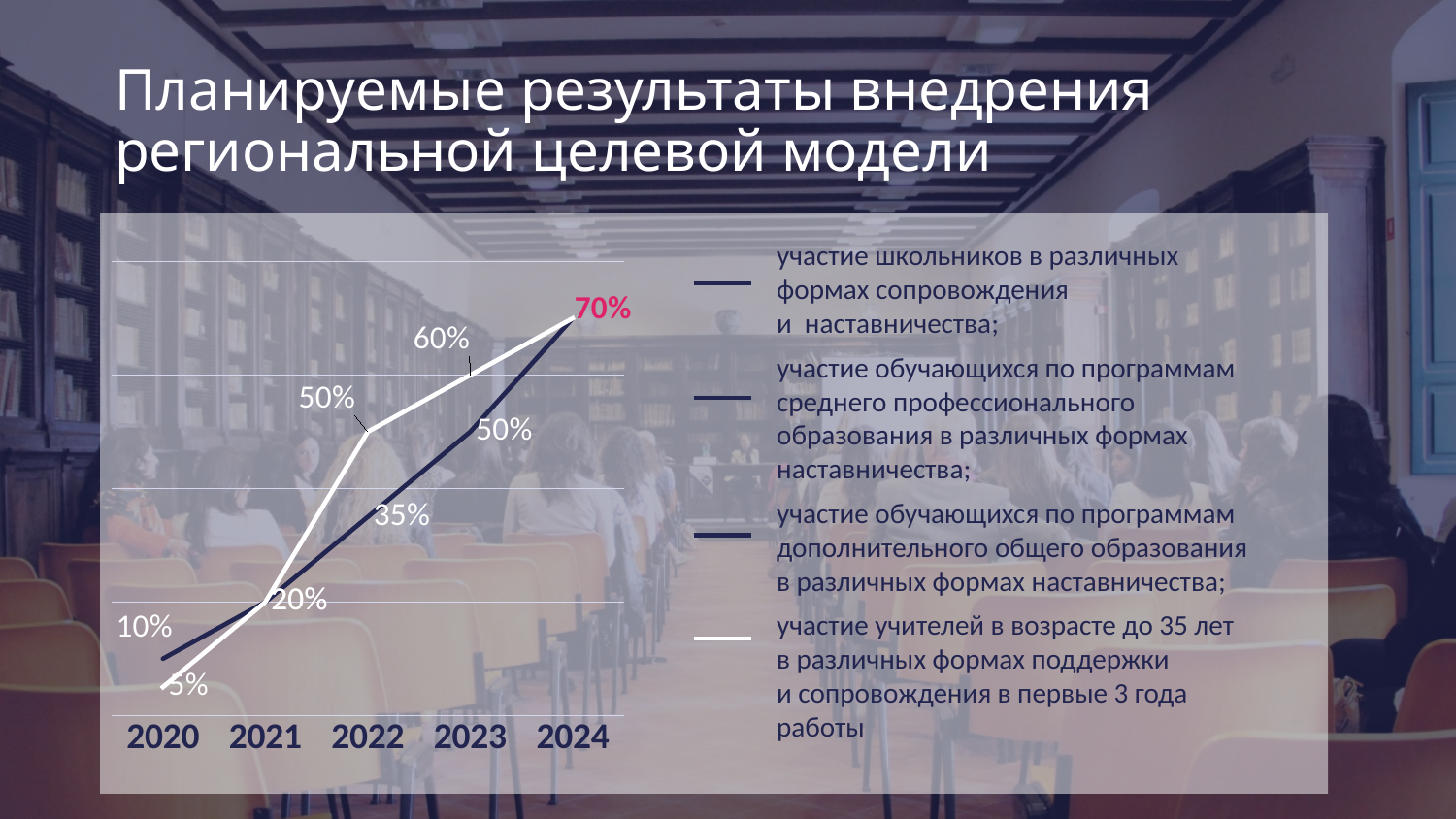
How many years are shown along the x axis of the chart? 5 By how many percentage points does the dark line increase from 2020 (10%) to 2024 (70%)? 60 percentage points What is the value of the white line (teachers under 35) in 2020? 5% How many entries does the chart's legend list? 4 What is the value of the dark line in 2022? 35% What value do the lines reach in 2024? 70% Do the values rise or fall from 2020 to 2024? Rise What is the value of the dark line in 2020? 10% What type of chart is shown on the slide? Line chart Which legend entry is represented by the white line? участие учителей в возрасте до 35 лет в различных формах поддержки и сопровождения в первые 3 года работы In 2023, which line has the higher value, the white line or the dark line? The white line What is the value of the white line in 2023? 60%